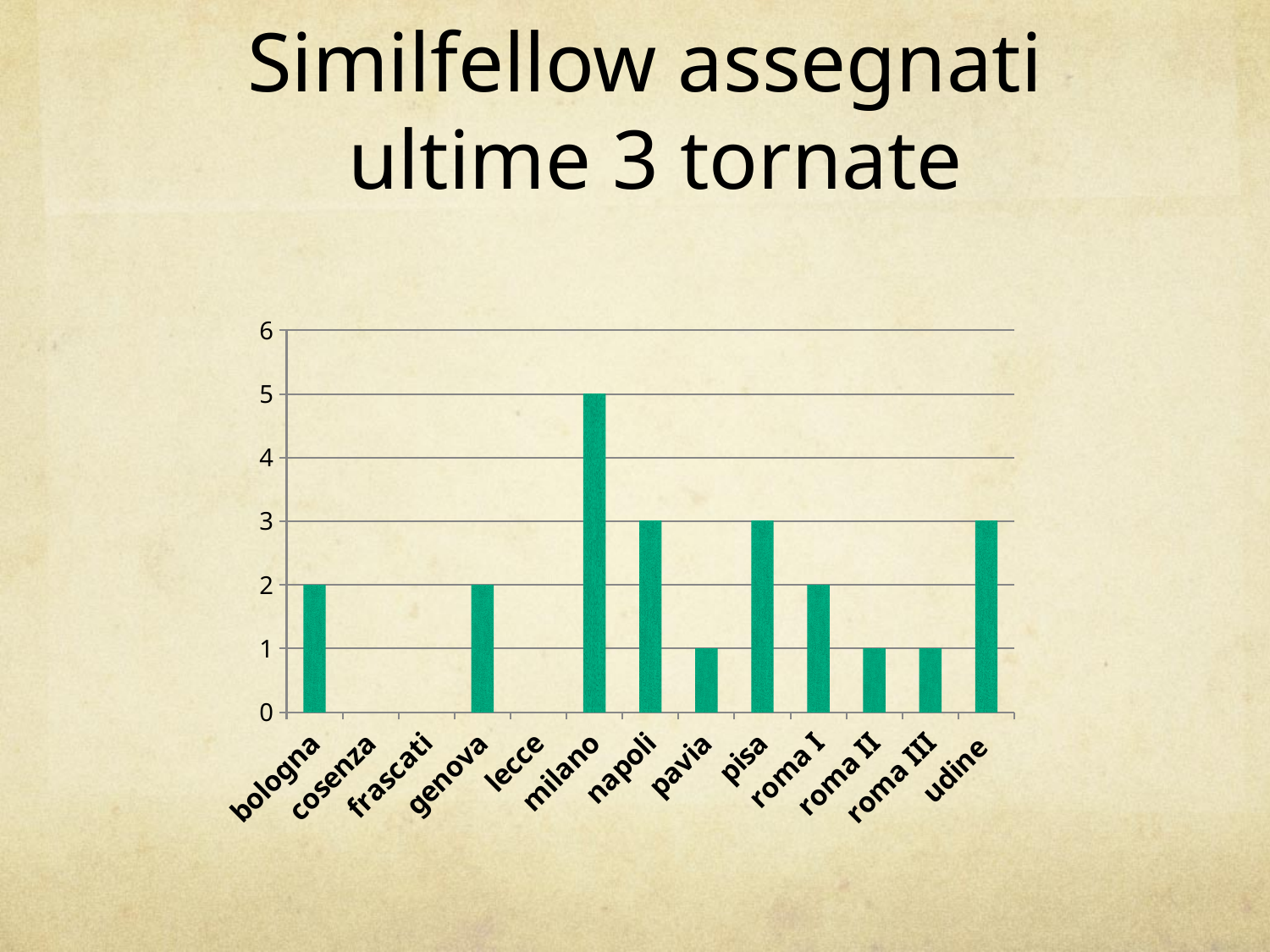
Which category has the highest value? milano What is the value for milano? 5 How many categories have a value of 3? 3 Is the value for milano greater or less than 4? greater What is the value for napoli? 3 What is the title of the chart? Similfellow assegnati ultime 3 tornate How many categories are shown on the x axis? 13 What is the value for pavia? 1 What is the value for bologna? 2 Which is larger, the value for pisa or the value for roma I? pisa What type of chart is shown on the slide? bar chart What is the difference between the values for milano and udine? 2